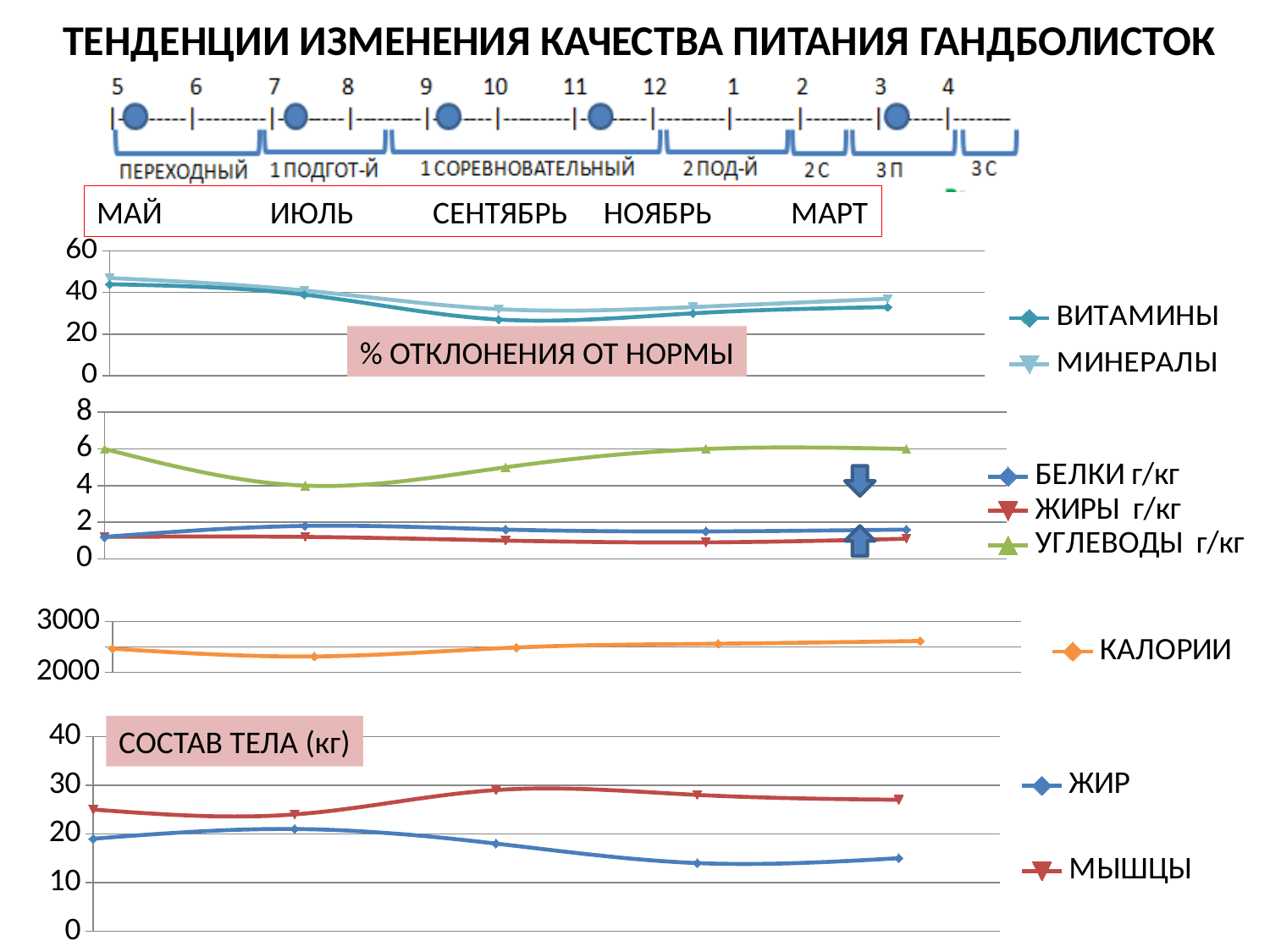
In the top chart, is the first value of МИНЕРАЛЫ greater or less than 40? greater In the bottom chart (СОСТАВ ТЕЛА), how many data points does the ЖИР line have? 5 In the top chart, is the third value of ВИТАМИНЫ greater or less than 40? less What type of chart is used for the ВИТАМИНЫ and МИНЕРАЛЫ data at the top of the slide? Line chart In the top chart, which series is higher at the third point, ВИТАМИНЫ or МИНЕРАЛЫ? МИНЕРАЛЫ In the second chart (БЕЛКИ, ЖИРЫ, УГЛЕВОДЫ), how many series does the legend list? 3 In the bottom chart (СОСТАВ ТЕЛА), which series is larger at the last point, ЖИР or МЫШЦЫ? МЫШЦЫ In the bottom chart (СОСТАВ ТЕЛА), is the last value of ЖИР greater or less than 20? less In the second chart, which series has the highest values? УГЛЕВОДЫ г/кг In the top chart (ВИТАМИНЫ / МИНЕРАЛЫ), how many series does the legend list? 2 In the second chart, what is the value of УГЛЕВОДЫ at the second point? 4